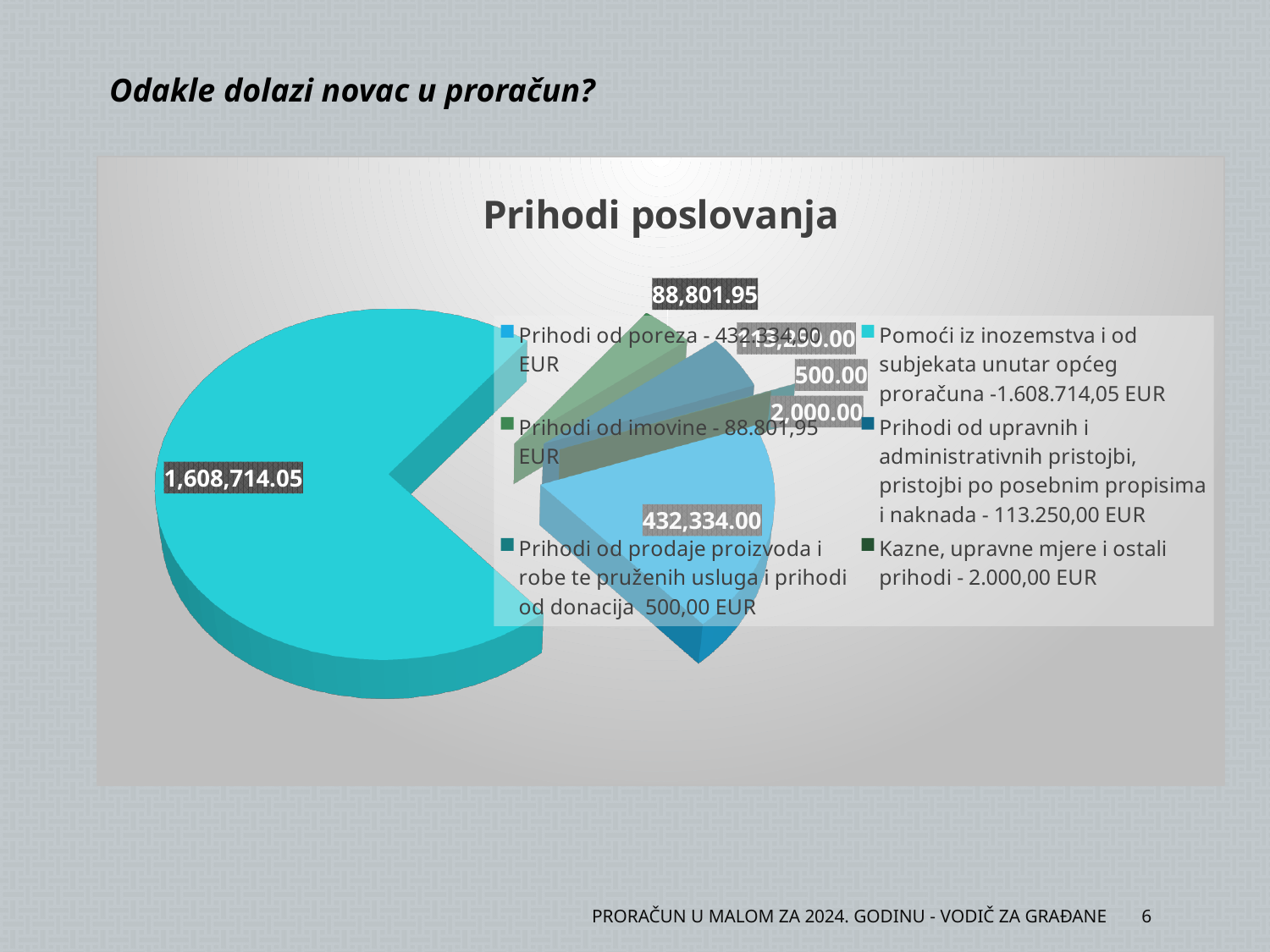
What is the data label value for Prihodi od poreza? 432,334.00 What is the difference between the value for Prihodi od poreza (432,334.00) and Prihodi od imovine (88,801.95)? 343,532.05 What kind of chart is shown on the slide? Pie chart Which is larger: Prihodi od poreza or Prihodi od imovine? Prihodi od poreza What is the title of the chart? Prihodi poslovanja What is the difference between the value for Kazne, upravne mjere i ostali prihodi (2,000.00) and Prihodi od prodaje proizvoda i robe te pruženih usluga i prihodi od donacija (500.00)? 1,500.00 Which category has the largest slice in the pie chart? Pomoći iz inozemstva i od subjekata unutar općeg proračuna How many slices does the pie chart have? 6 What is the data label value for Kazne, upravne mjere i ostali prihodi? 2,000.00 What is the value of the largest slice of the pie chart? 1,608,714.05 What is the data label value for Prihodi od imovine? 88,801.95 Which category has the smallest slice in the pie chart? Prihodi od prodaje proizvoda i robe te pruženih usluga i prihodi od donacija